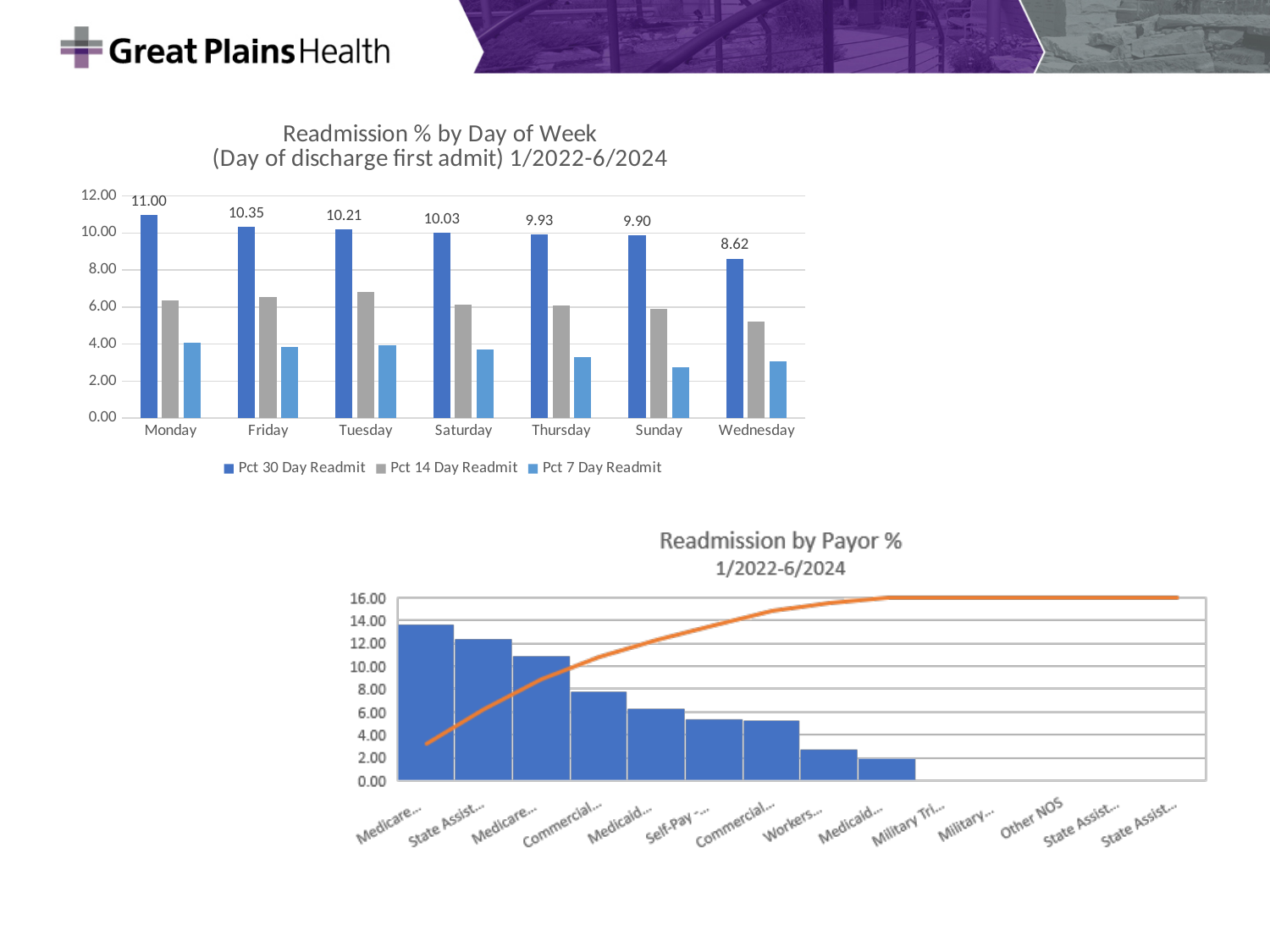
In the 'Readmission % by Day of Week' chart, what is the Pct 30 Day Readmit value for Saturday? 10.03 In the 'Readmission % by Day of Week' chart, how many days of the week are shown on the x axis? 7 In the 'Readmission % by Day of Week' chart, what is the Pct 30 Day Readmit value for Monday? 11.00 In the 'Readmission % by Day of Week' chart, how many series does the legend list? 3 In the 'Readmission % by Day of Week' chart, do the Pct 30 Day Readmit values rise or fall from left to right? fall In the 'Readmission % by Day of Week' chart, is the Pct 30 Day Readmit value higher for Friday or Tuesday? Friday In the 'Readmission % by Day of Week' chart, which day has the highest Pct 30 Day Readmit value? Monday In the 'Readmission % by Day of Week' chart, what is the Pct 30 Day Readmit value for Wednesday? 8.62 In the 'Readmission % by Day of Week' chart, is the Pct 7 Day Readmit value for Sunday greater or less than 4.00? less What kind of chart is the 'Readmission by Payor %' chart at the bottom of the slide? bar chart with a line In the 'Readmission % by Day of Week' chart, which day has the lowest Pct 30 Day Readmit value? Wednesday In the 'Readmission % by Day of Week' chart, what is the difference between the Pct 30 Day Readmit values for Monday and Wednesday? 2.38